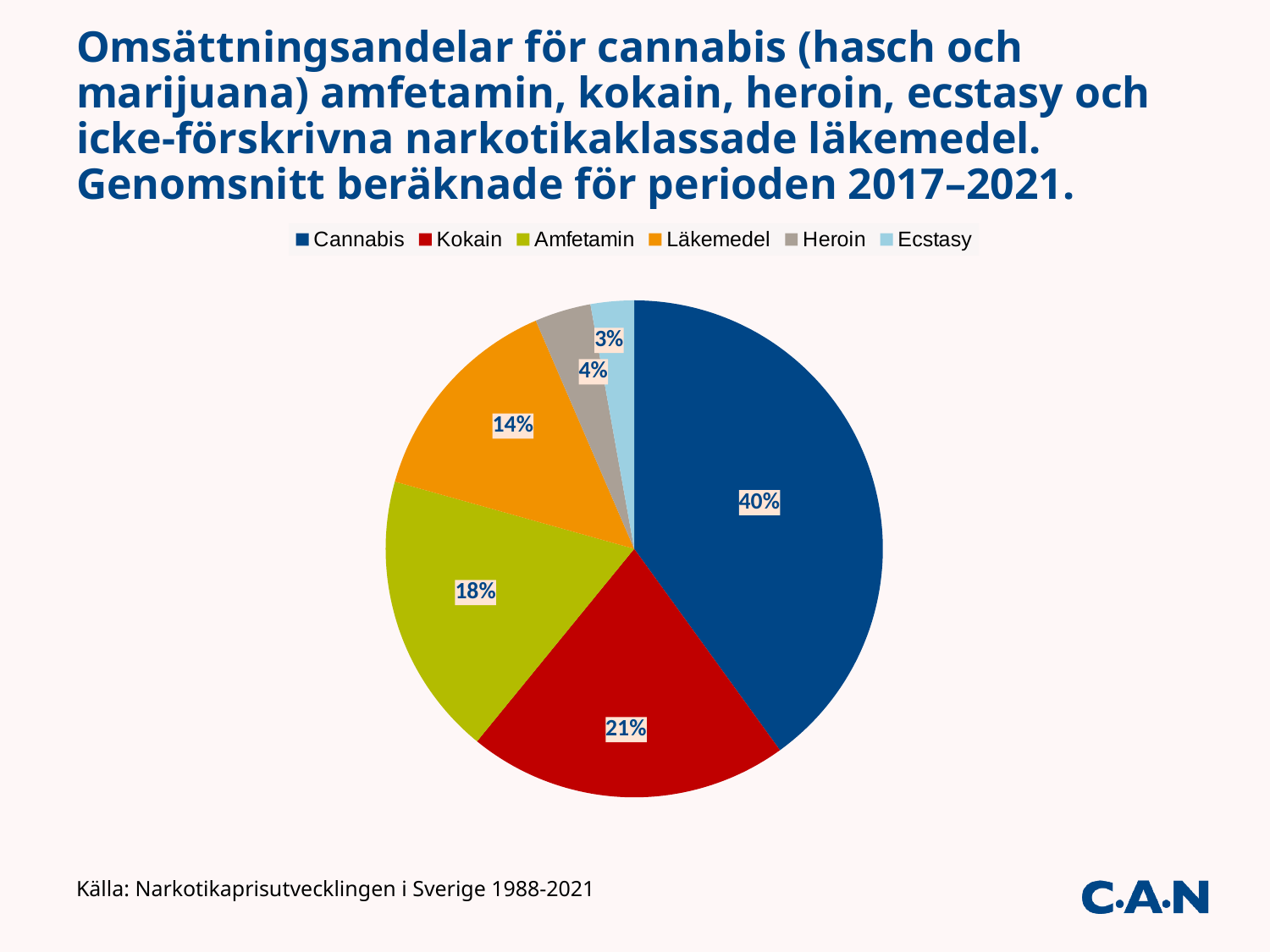
How many categories are shown in the pie chart? 6 Which is larger, the share for Amfetamin or the share for Läkemedel? Amfetamin Which category has the largest slice of the pie? Cannabis What is the value shown for Heroin? 4% What type of chart is shown on the slide? Pie chart What is the value shown for Läkemedel? 14% What share of the pie does Cannabis account for? 40% Which category has the smallest slice of the pie? Ecstasy What is the value shown for Kokain? 21% What is the value shown for Amfetamin? 18% What is the difference in percentage points between Cannabis and Kokain? 19 What is the value shown for Ecstasy? 3%